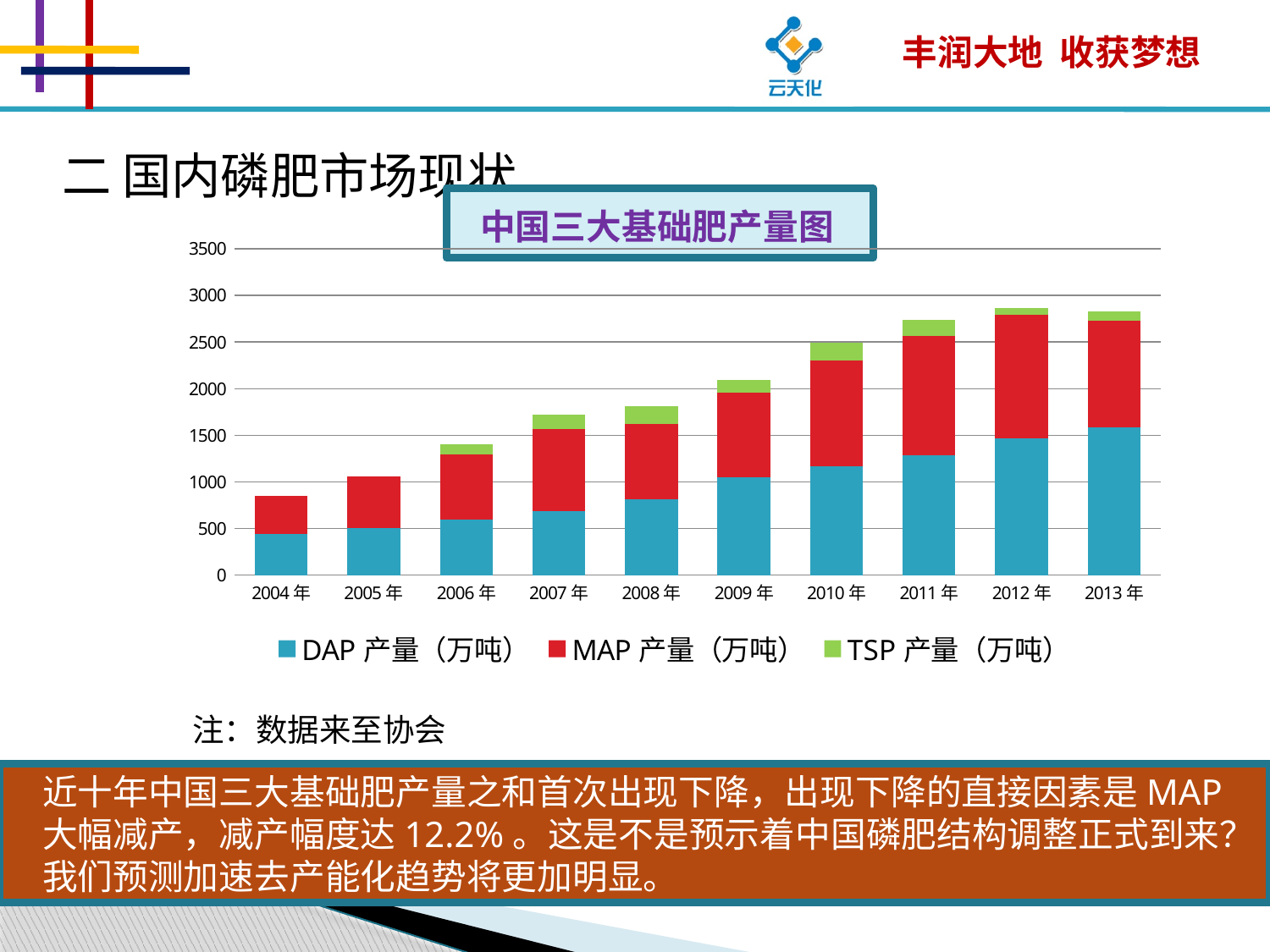
What is the title of the chart? 中国三大基础肥产量图 What kind of chart is shown on the slide? Stacked bar chart Which series is shown in red? MAP 产量（万吨） Is the DAP 产量 value for 2013年 greater or less than 1500? greater In which year is DAP 产量 the highest? 2013年 How many years are shown on the x axis? 10 In which year is DAP 产量 the lowest? 2004年 Does DAP 产量 rise or fall from 2004年 to 2013年? Rise Which is larger, the DAP 产量 for 2010年 or the DAP 产量 for 2006年? 2010年 Is the total stacked value for 2012年 greater or less than 2500? greater How many series does the legend list? 3 Is the DAP 产量 value for 2004年 greater or less than 500? less